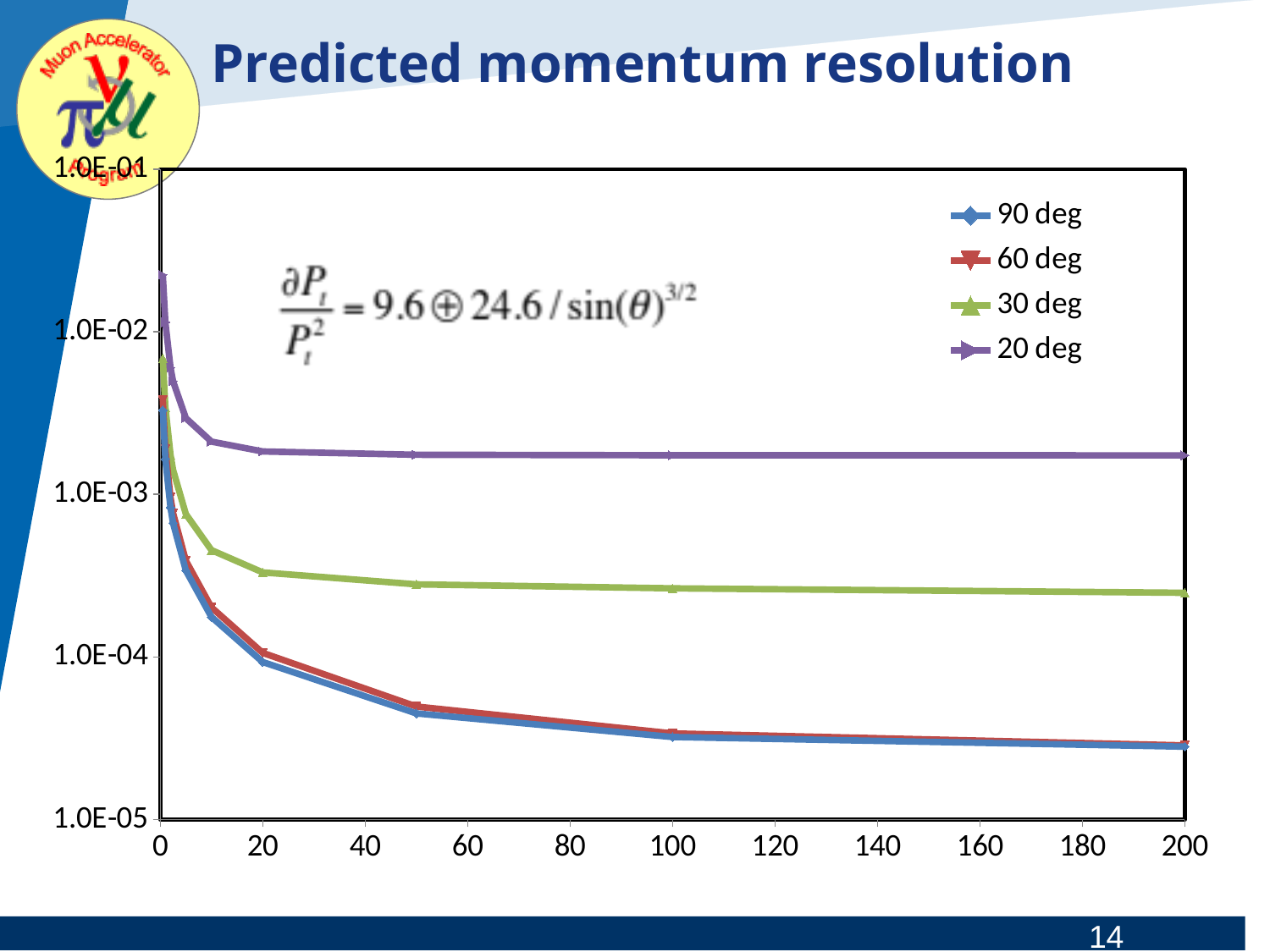
Is the value for 90 deg at x = 200 greater or less than 1.0E-04? less What kind of chart is shown on the slide? line chart Is the value for 30 deg at x = 100 greater or less than 1.0E-04? greater Which series are listed in the legend? 90 deg, 60 deg, 30 deg, 20 deg Is the value for 30 deg at x = 200 greater or less than 1.0E-03? less What is the title of the chart on the slide? Predicted momentum resolution At x = 100, which is larger: the value for 20 deg or the value for 30 deg? 20 deg Do the values of the 30 deg series rise or fall as the x-axis value increases? fall At x = 200, which is larger: the value for 30 deg or the value for 90 deg? 30 deg Which series has the highest values across the whole x-axis range? 20 deg How many series does the legend list? 4